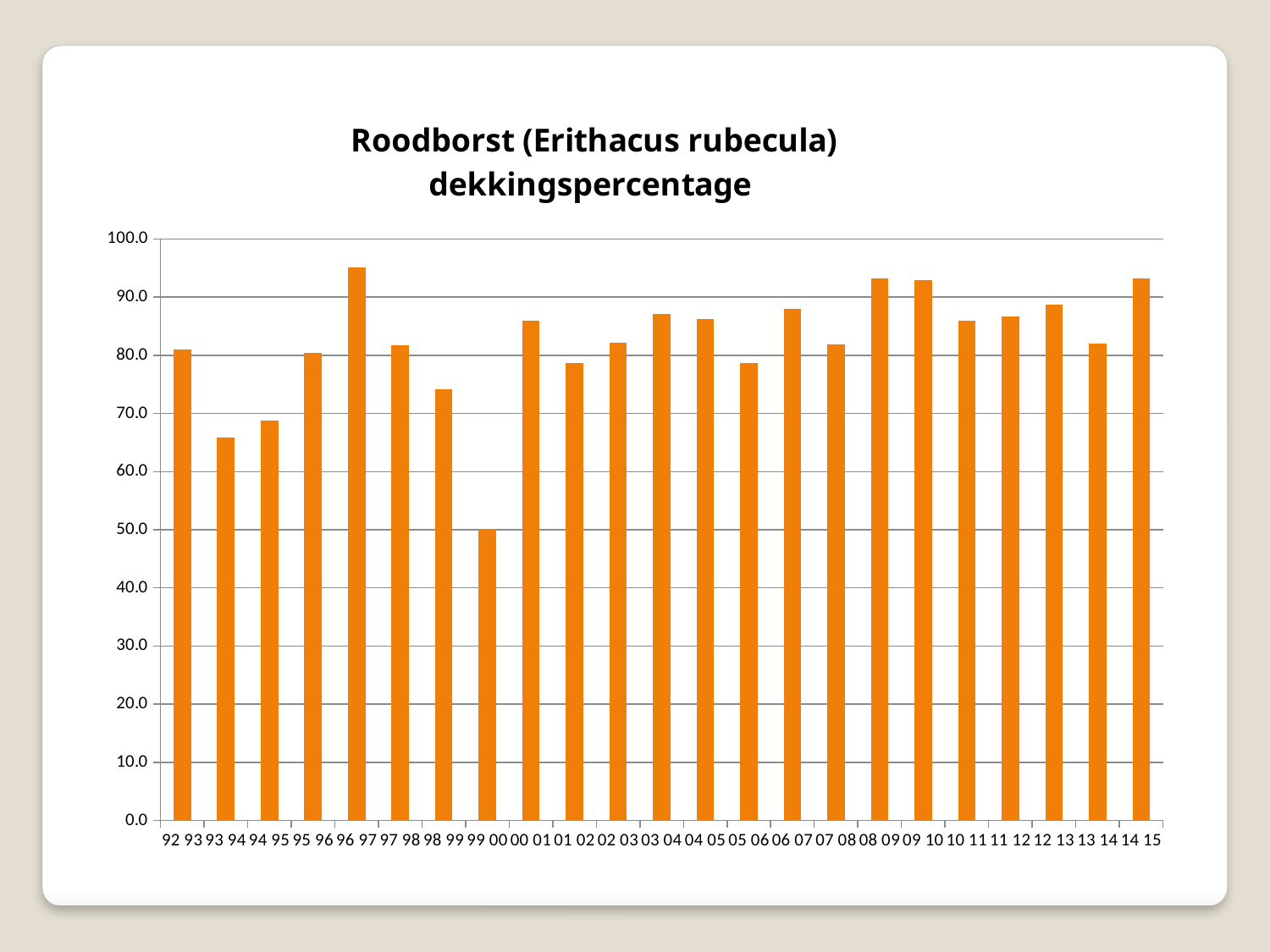
Is the value for 99 00 greater or less than 60? less Which season has the lowest dekkingspercentage? 99 00 What kind of chart is shown on the slide? bar chart Is the value for 93 94 greater or less than 70? less Is the value for 96 97 greater or less than 90? greater Do the values rise or fall from 96 97 to 99 00? fall What is the title of the chart? Roodborst (Erithacus rubecula) dekkingspercentage How many bars (seasons) are plotted in the chart? 23 Which season has the larger value, 93 94 or 98 99? 98 99 Which season has the highest dekkingspercentage? 96 97